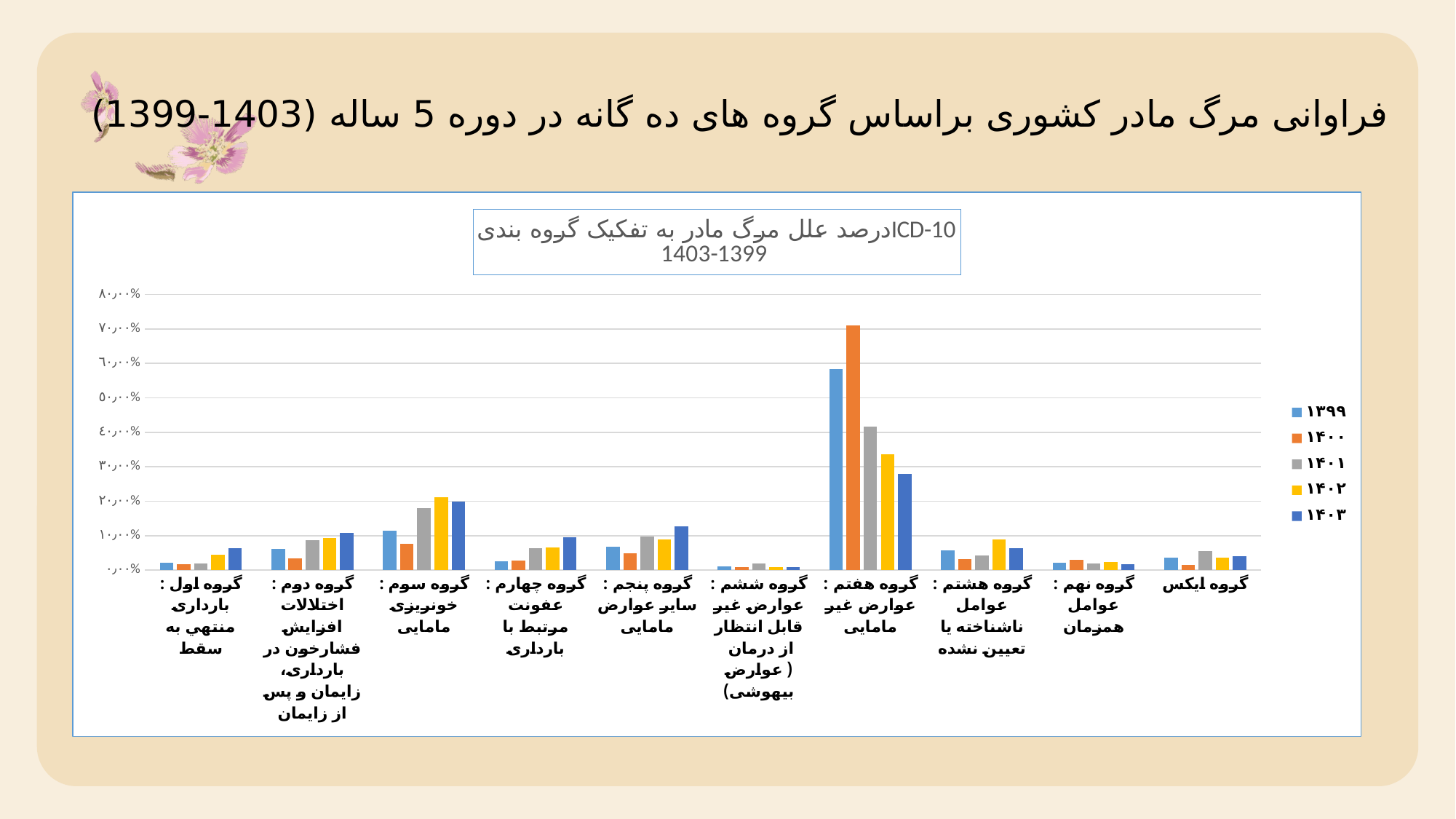
How many categories (groups) are shown along the x axis? 10 Which category has the highest bars overall? گروه هفتم : عوارض غیر مامایی In گروه سوم, which is larger: the value for ۱۴۰۲ or the value for ۱۳۹۹? ۱۴۰۲ Is the value for ۱۴۰۲ in گروه هفتم greater or less than 40%? less Is the value for ۱۳۹۹ in گروه هفتم greater or less than 50%? greater What kind of chart is shown on the slide? bar chart In the category گروه هفتم, which series has the highest value? ۱۴۰۰ What is the title of the chart? درصد علل مرگ مادر به تفکیک گروه بندی ICD-10 1403-1399 Is the value for ۱۴۰۰ in گروه هفتم greater or less than 60%? greater How many series does the legend list? 5 Which category has the lowest bars overall? گروه ششم : عوارض غیر قابل انتظار از درمان (عوارض بیهوشی) In the category گروه هفتم, which series has the lowest value? ۱۴۰۳